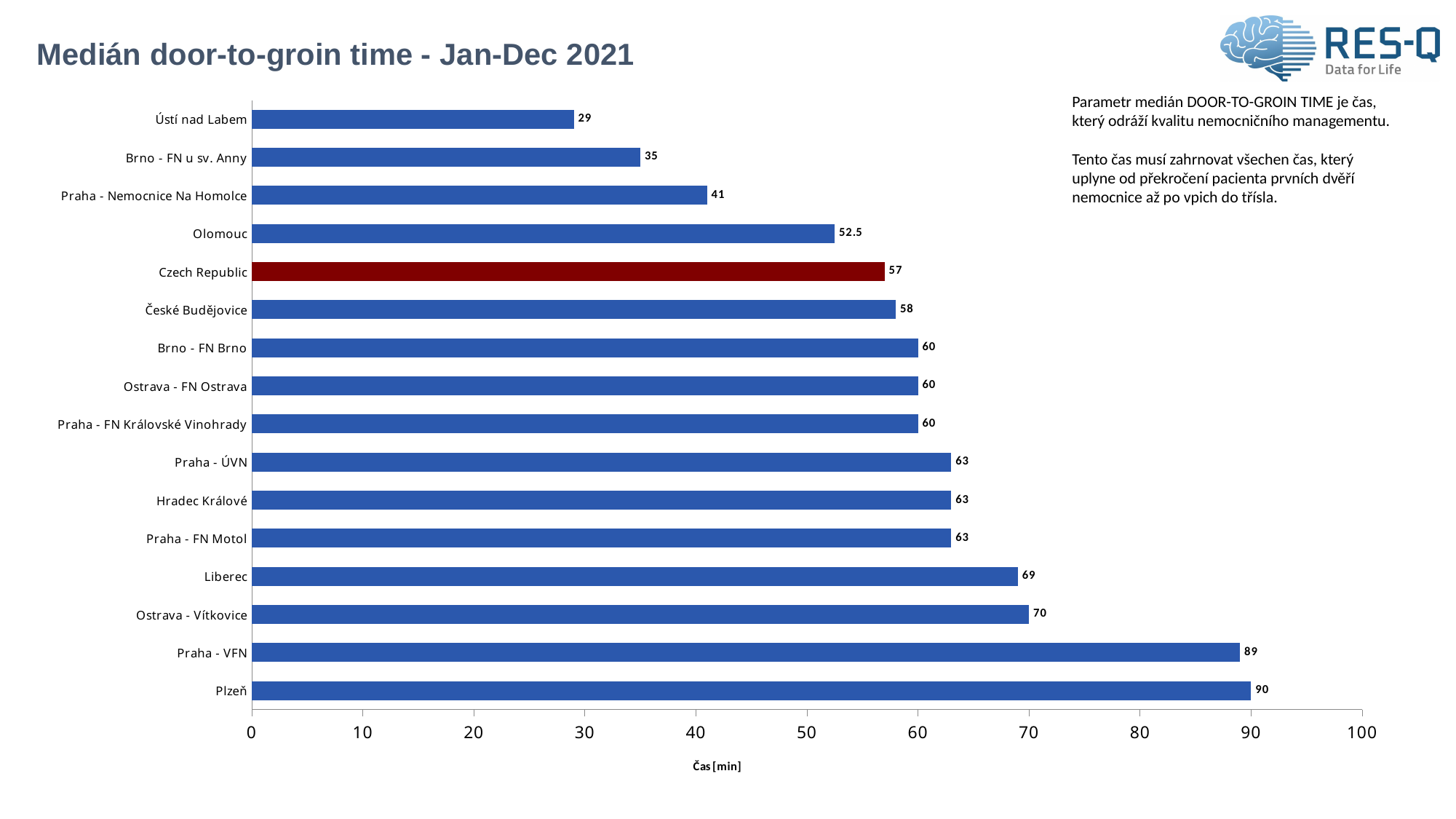
Which category has the lowest median door-to-groin time? Ústí nad Labem What is the value shown for Czech Republic? 57 Is the value for Praha - Nemocnice Na Homolce greater or less than 50? less What is the difference between the values for Liberec and Brno - FN u sv. Anny? 34 What is the difference between the values for Plzeň and Ústí nad Labem? 61 Which category has the highest median door-to-groin time? Plzeň What is the label of the horizontal axis? Čas [min] What kind of chart is shown on the slide? bar chart What is the median door-to-groin time for Praha - VFN? 89 Which has a larger value, Ostrava - Vítkovice or Praha - ÚVN? Ostrava - Vítkovice How many categories are shown on the chart? 16 What is the median door-to-groin time for Olomouc? 52.5